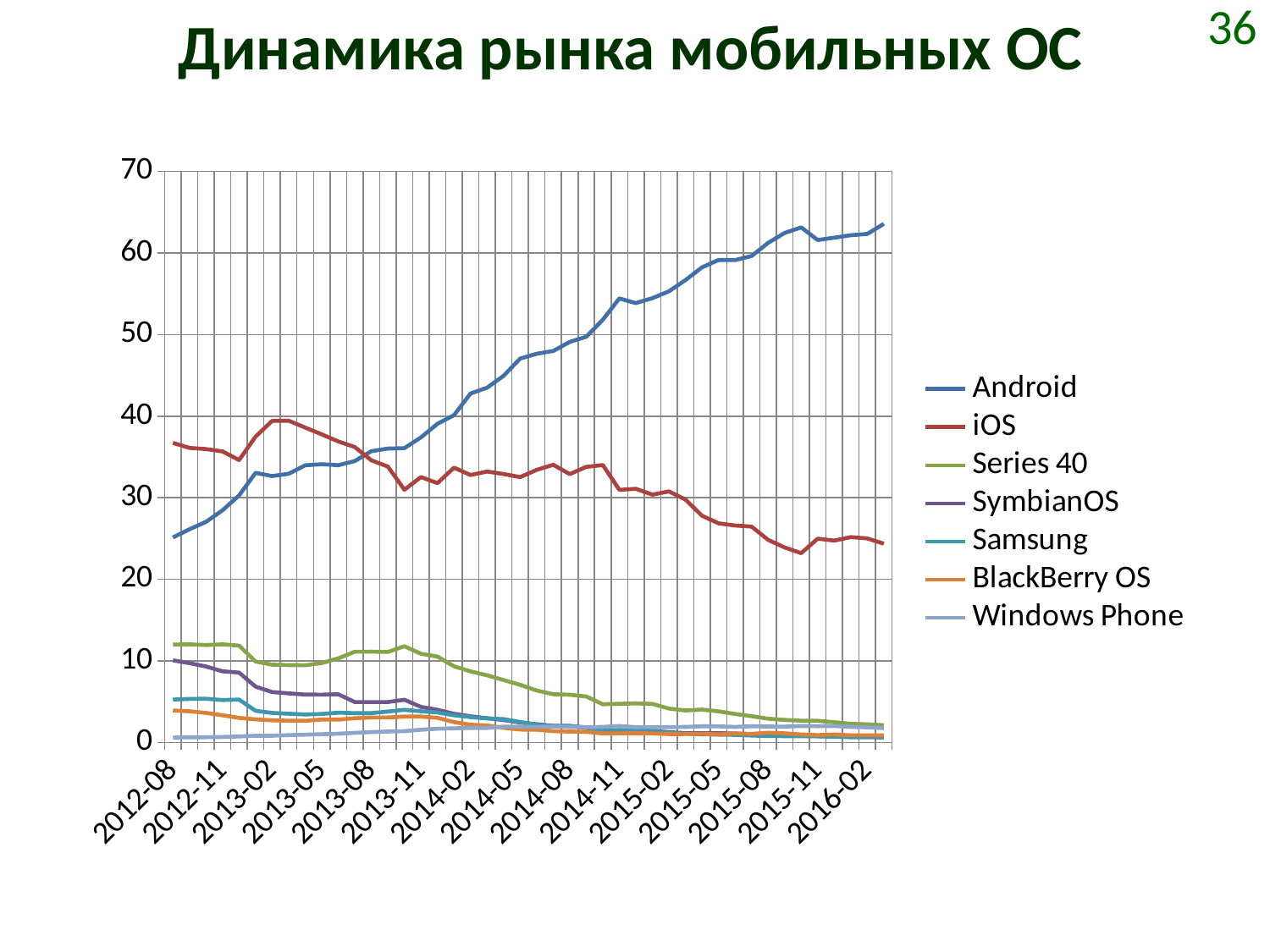
What kind of chart is shown on the slide? line chart Is the value for Series 40 at 2012-08 greater or less than 10? greater What is the title of the chart? Динамика рынка мобильных ОС Is the value for Android at 2016-02 greater or less than 60? greater Does the iOS series rise or fall from 2013-02 to 2016-02? fall Which series is listed first in the legend? Android Does the Android series rise or fall from 2012-08 to 2016-02? rise Is the value for iOS at 2015-11 greater or less than 30? less How many series does the legend list? 7 Which is larger at 2012-08, the value for Android or the value for iOS? iOS Which series has the highest value at 2016-02? Android